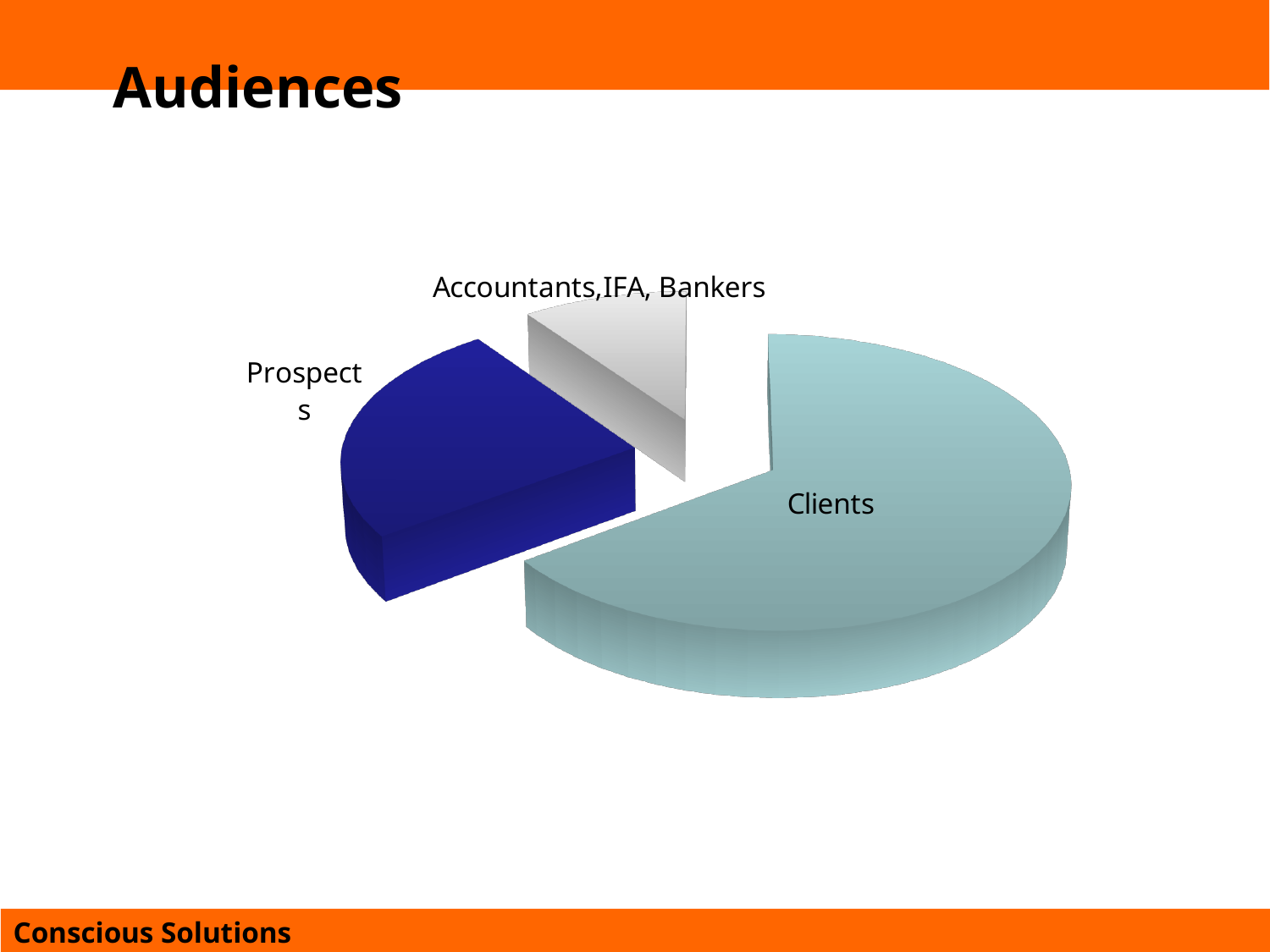
What is the title of the slide containing the pie chart? Audiences Which category has the smallest slice of the pie chart? Accountants,IFA, Bankers How many slices does the pie chart have? 3 Which category has the largest slice of the pie chart? Clients Which slice is larger, Clients or Prospects? Clients What colour is the Prospects slice of the pie chart? dark blue Which slice is larger, Prospects or Accountants,IFA, Bankers? Prospects What kind of chart is shown on the slide? pie chart